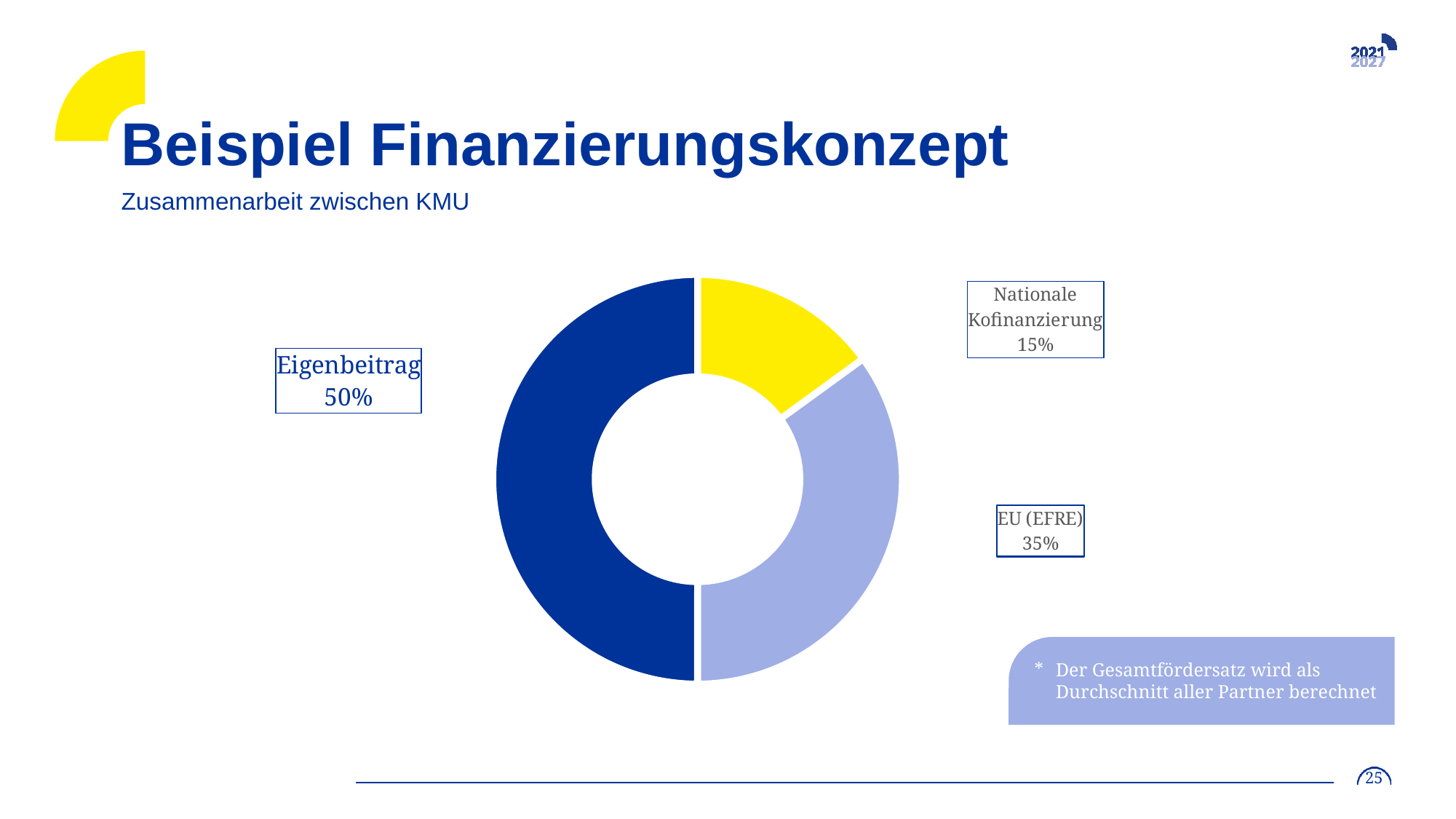
What share of the financing does Eigenbeitrag account for? 50% What is the difference in percentage points between EU (EFRE) and Nationale Kofinanzierung? 20 What colour is the Eigenbeitrag segment of the chart? Dark blue Which category has the largest share of the chart? Eigenbeitrag Which is larger, the share for EU (EFRE) or the share for Nationale Kofinanzierung? EU (EFRE) What share of the financing does Nationale Kofinanzierung account for? 15% What is the difference in percentage points between Eigenbeitrag and EU (EFRE)? 15 What colour is the Nationale Kofinanzierung segment of the chart? Yellow How many categories are shown in the chart? 3 Which category has the smallest share of the chart? Nationale Kofinanzierung What share of the financing does EU (EFRE) account for? 35% What kind of chart is shown on the slide? Doughnut chart